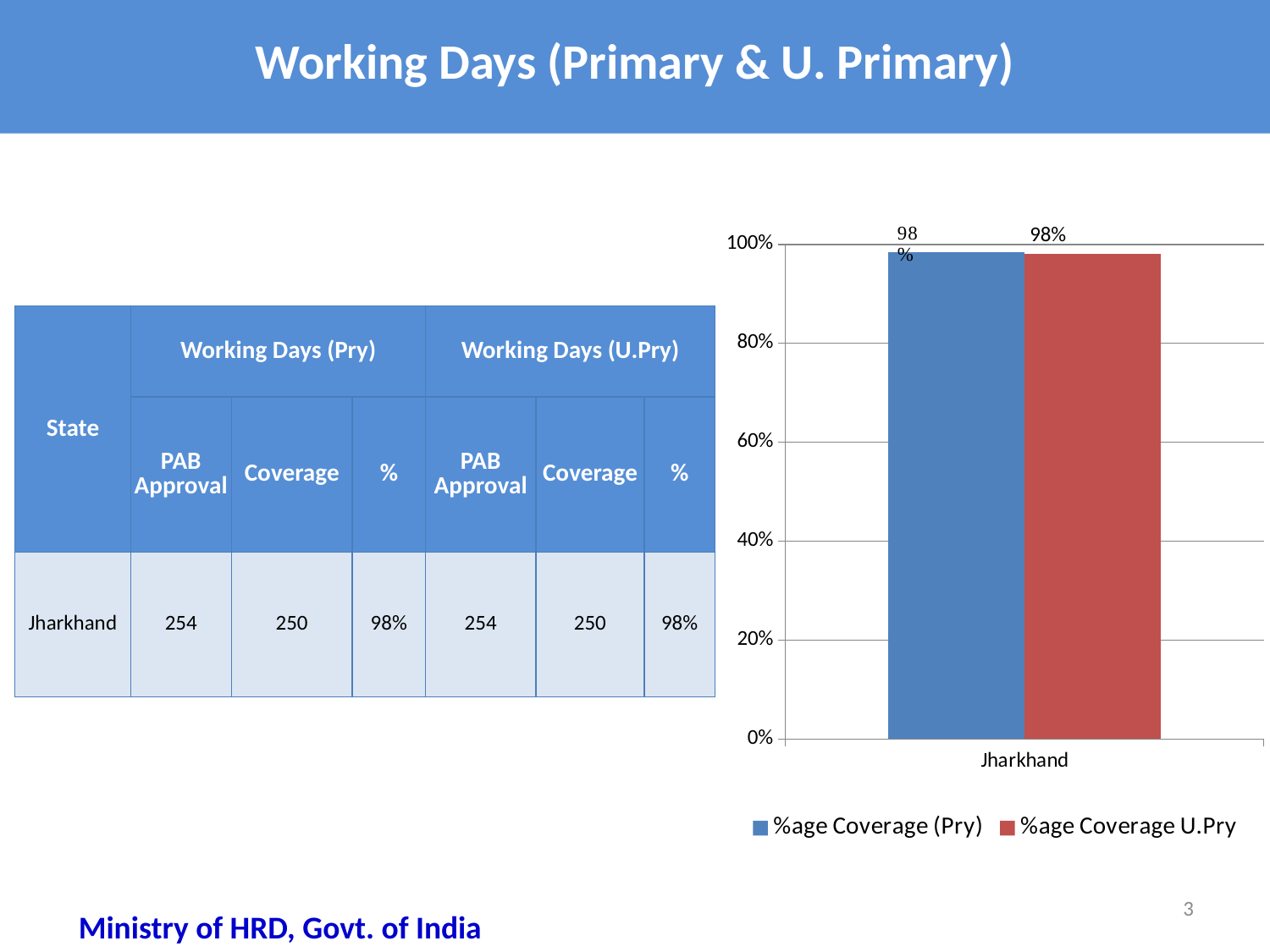
What is the value of %age Coverage (Pry) for Jharkhand in the chart? 98% What is the highest value shown on the y axis of the chart? 100% Is the value for %age Coverage U.Pry for Jharkhand greater or less than 60%? greater Which category is shown on the x axis of the chart? Jharkhand What colour is the bar for %age Coverage U.Pry in the chart? red What is the difference between %age Coverage (Pry) and %age Coverage U.Pry for Jharkhand? 0% How many series does the chart legend list? 2 Is the value for %age Coverage (Pry) for Jharkhand greater or less than 80%? greater What is the value of %age Coverage U.Pry for Jharkhand in the chart? 98% What kind of chart is shown on the slide? bar chart How many categories are plotted on the x axis of the chart? 1